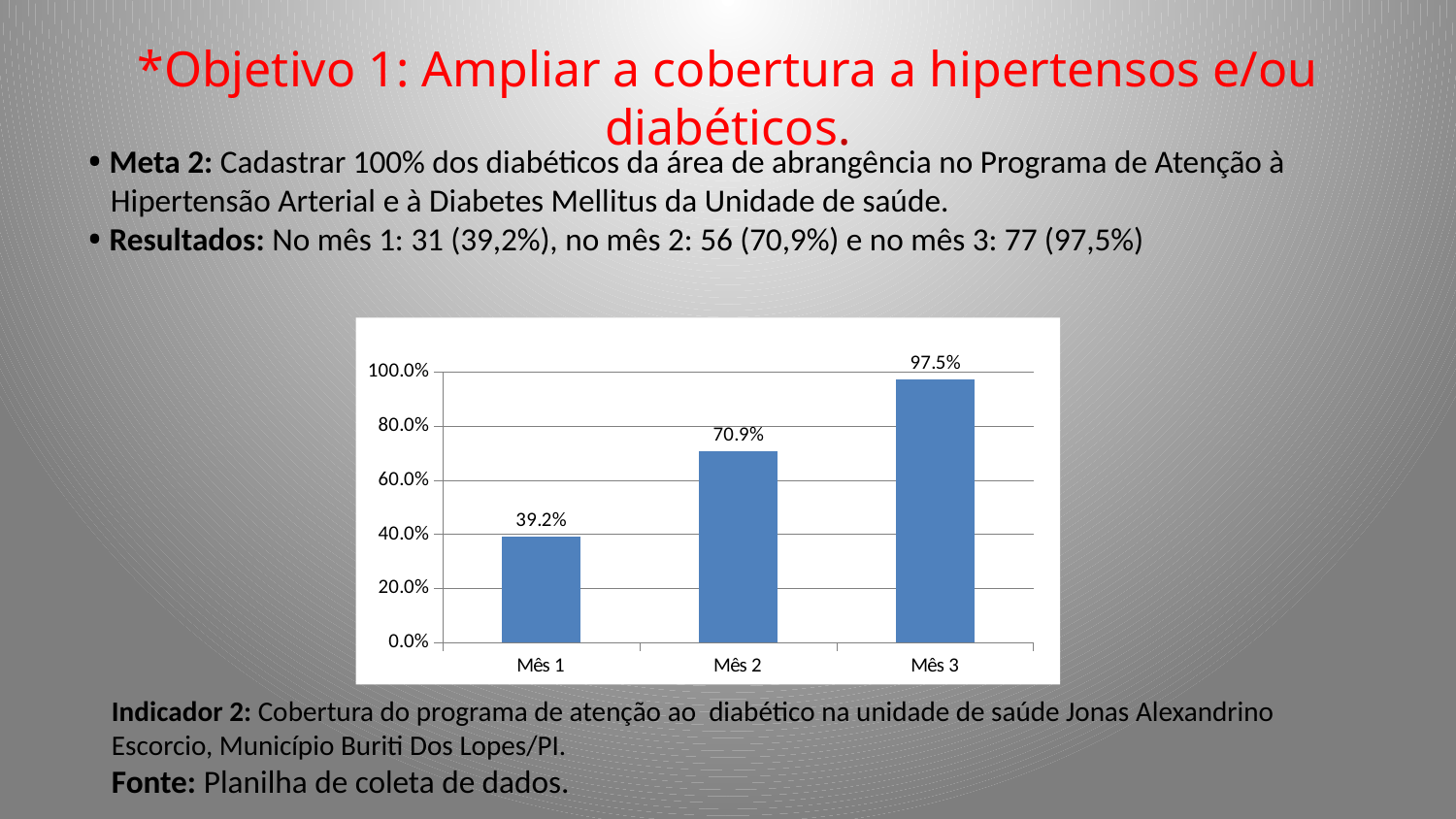
What is the value for Mês 2? 70.9% What is the value for Mês 3? 97.5% What is the difference between the values for Mês 3 and Mês 1? 58.3% What is the value for Mês 1? 39.2% Do the values rise or fall from Mês 1 to Mês 3? rise Which month has the lowest value? Mês 1 How many months are shown on the x axis? 3 Which month has the highest value? Mês 3 Which is larger, the value for Mês 2 or the value for Mês 3? Mês 3 What is the difference between the values for Mês 2 and Mês 1? 31.7% What kind of chart is shown on the slide? bar chart Is the value for Mês 2 greater or less than 60.0%? greater